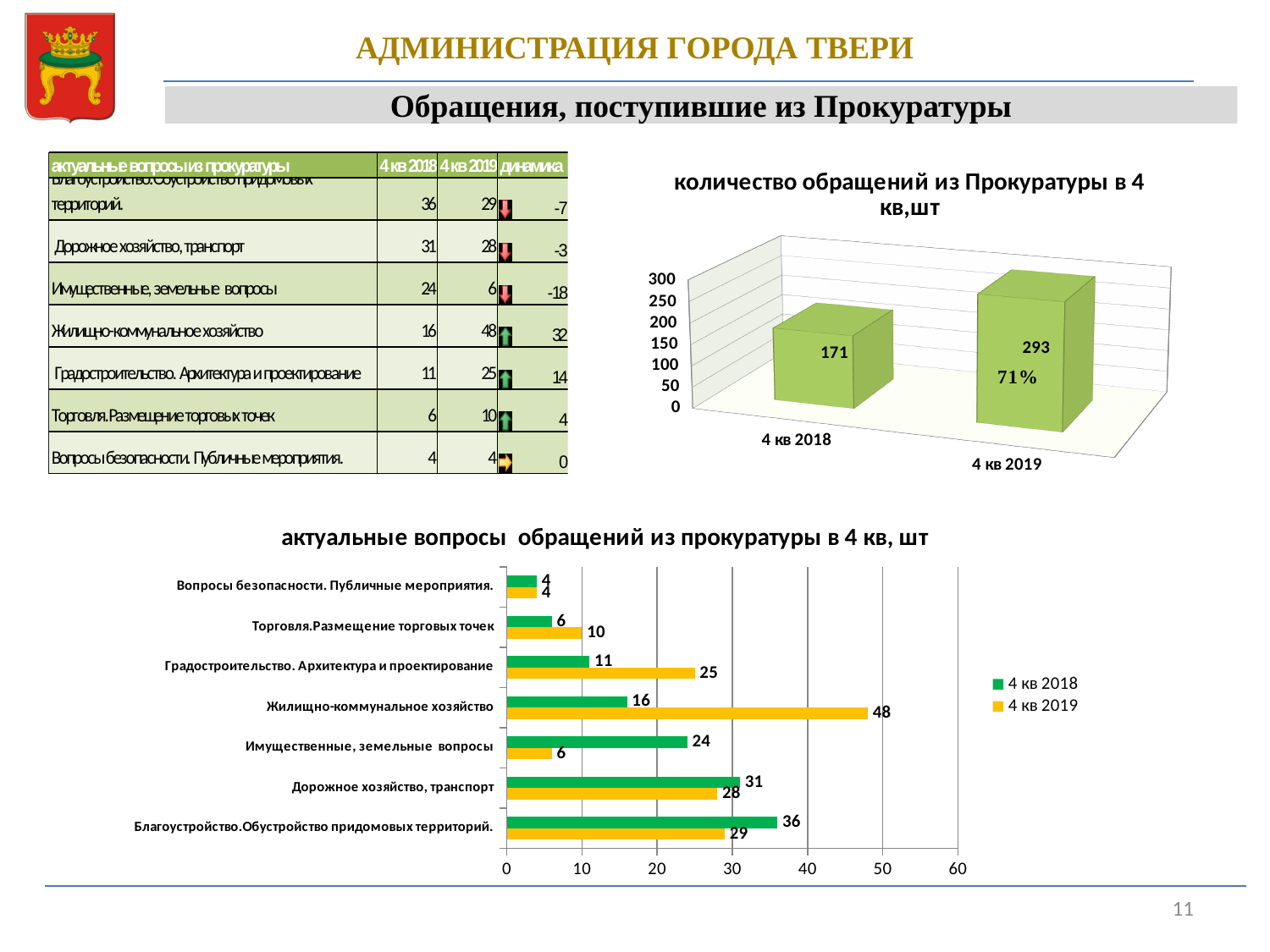
In the chart 'количество обращений из Прокуратуры в 4 кв,шт', what is the value for 4 кв 2019? 293 In the chart 'количество обращений из Прокуратуры в 4 кв,шт', what is the difference between the 4 кв 2019 and 4 кв 2018 values? 122 In the chart 'количество обращений из Прокуратуры в 4 кв,шт', how many bars are plotted? 2 In the chart 'актуальные вопросы обращений из прокуратуры в 4 кв, шт', how many series does the legend list? 2 In the chart 'актуальные вопросы обращений из прокуратуры в 4 кв, шт', what is the 4 кв 2019 value for Жилищно-коммунальное хозяйство? 48 In the chart 'количество обращений из Прокуратуры в 4 кв,шт', what is the value for 4 кв 2018? 171 In the chart 'актуальные вопросы обращений из прокуратуры в 4 кв, шт', which category has the lowest 4 кв 2018 value? Вопросы безопасности. Публичные мероприятия. In the chart 'актуальные вопросы обращений из прокуратуры в 4 кв, шт', what is the difference between the 4 кв 2019 and 4 кв 2018 values for Градостроительство. Архитектура и проектирование? 14 What kind of chart is 'актуальные вопросы обращений из прокуратуры в 4 кв, шт'? bar chart In the chart 'актуальные вопросы обращений из прокуратуры в 4 кв, шт', which category has the highest 4 кв 2019 value? Жилищно-коммунальное хозяйство In the chart 'актуальные вопросы обращений из прокуратуры в 4 кв, шт', which is larger for Дорожное хозяйство, транспорт: the 4 кв 2018 value or the 4 кв 2019 value? 4 кв 2018 In the chart 'актуальные вопросы обращений из прокуратуры в 4 кв, шт', what is the 4 кв 2018 value for Имущественные, земельные вопросы? 24